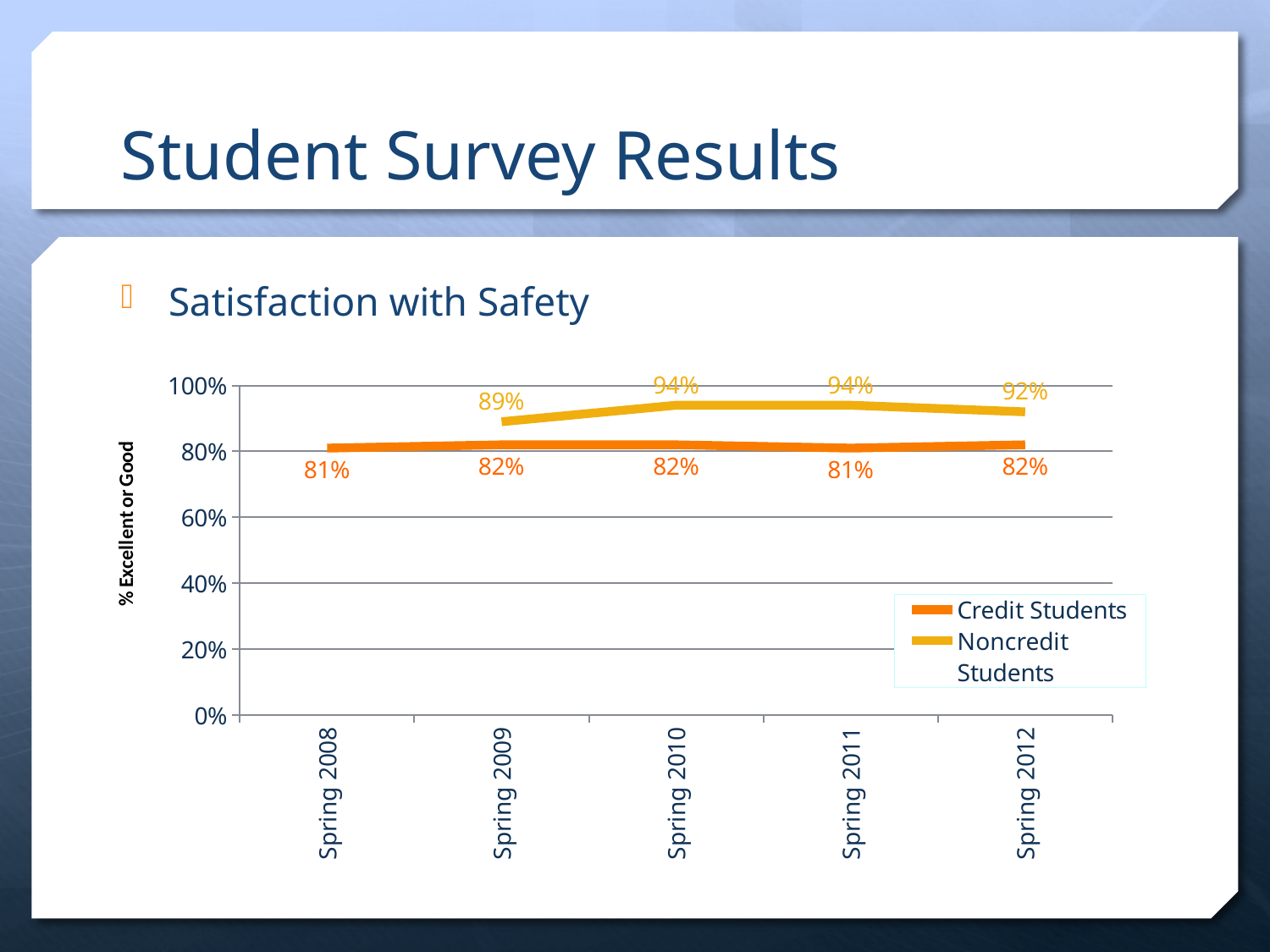
What is the label on the vertical axis? % Excellent or Good In which year does the Noncredit Students series reach its lowest value? Spring 2009 What is the difference between Noncredit Students and Credit Students in Spring 2010? 12% What is the value for Noncredit Students in Spring 2012? 92% Which series has the higher value in Spring 2011, Credit Students or Noncredit Students? Noncredit Students What kind of chart is shown on the slide? Line chart What is the value for Credit Students in Spring 2011? 81% What is the value for Noncredit Students in Spring 2009? 89% What is the difference between the Noncredit Students values in Spring 2010 and Spring 2012? 2% How many time points are shown on the x axis? 5 How many series does the legend list? 2 What is the value for Credit Students in Spring 2008? 81%